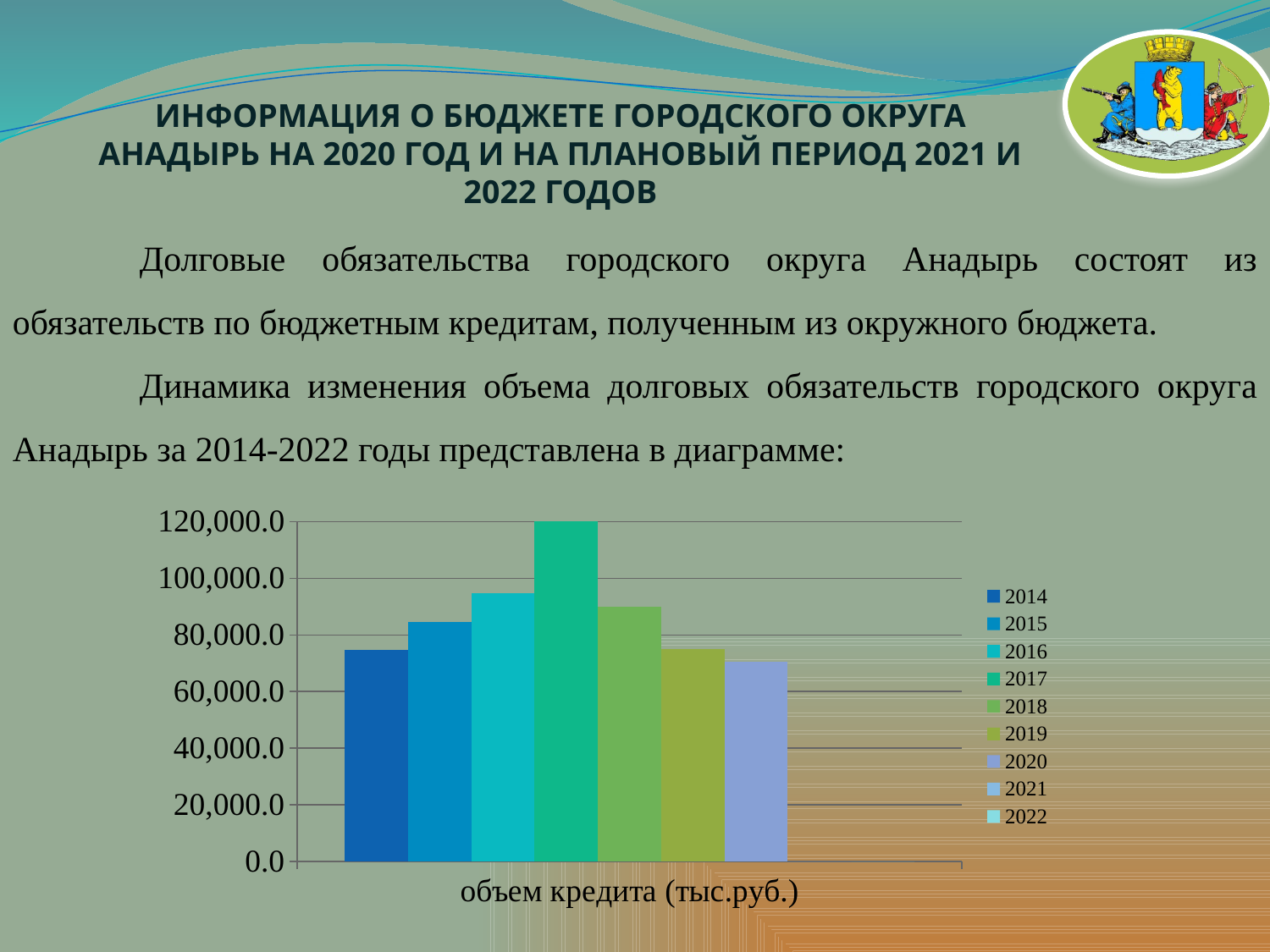
Is the value for 2015 greater or less than 80,000.0? greater How many bars are plotted in the chart? 7 Among the bars plotted, which year has the shortest bar? 2020 Is the value for 2014 greater or less than 80,000.0? less Which is larger, the value for 2016 or the value for 2018? 2016 What is the label shown under the x axis of the chart? объем кредита (тыс.руб.) Is the value for 2019 greater or less than 80,000.0? less Which year has the tallest bar in the chart? 2017 How many series does the chart legend list? 9 What kind of chart is shown on the slide? bar chart Do the values rise or fall from 2017 to 2020? fall